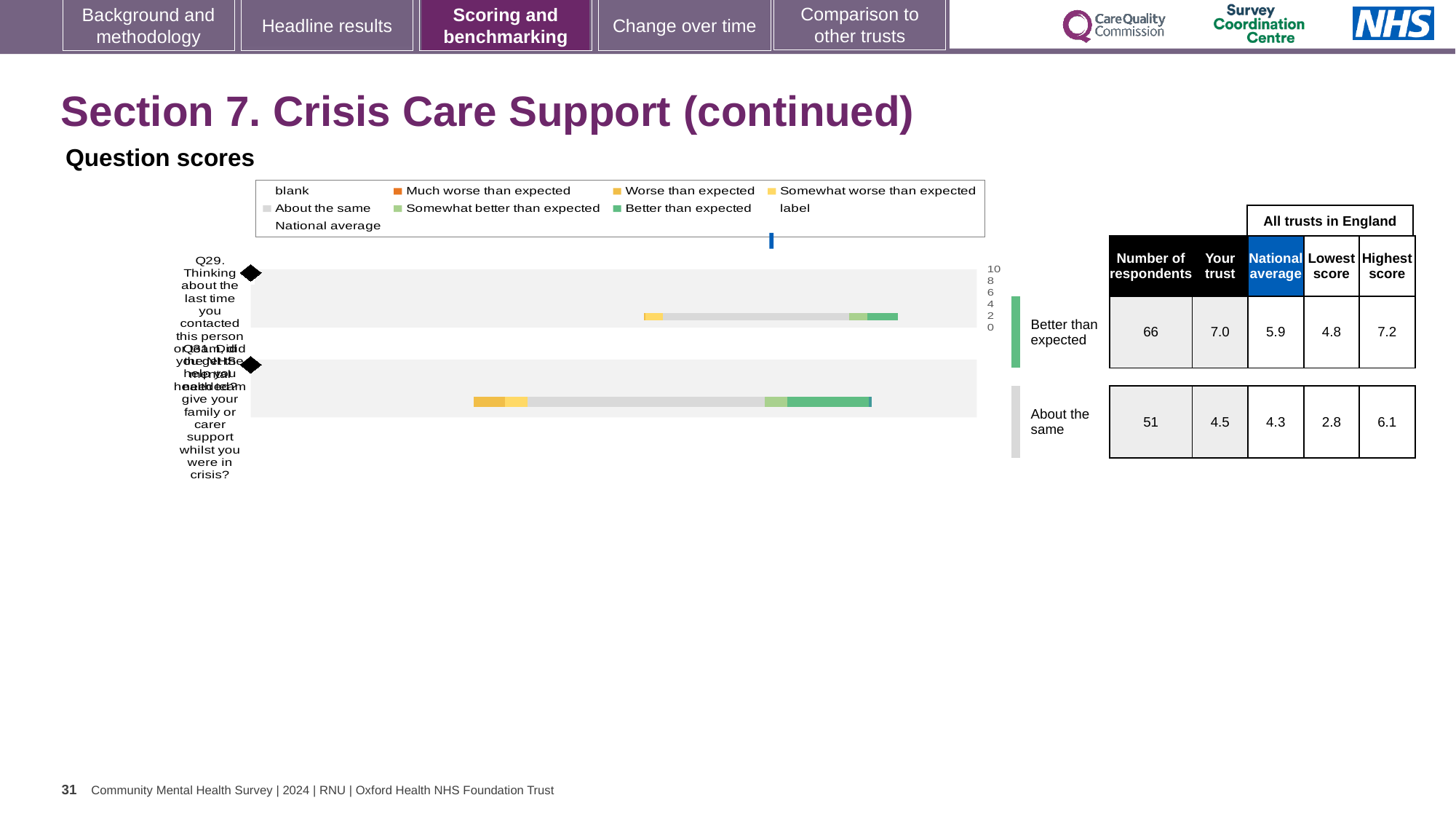
What kind of chart is used to show the question scores on this slide? Bar chart What is the difference between the 'Your trust' score and the national average for Q29? 1.1 In the table next to the chart, what is the highest score among all trusts in England for Q31? 6.1 Which two questions are plotted in the question scores chart? Q29 and Q31 What is the difference in the number of respondents between Q29 and Q31? 15 How many questions (bars) are plotted in the question scores chart? 2 In the question scores chart, what colour represents 'Better than expected' in the legend? Green In the table next to the chart, what is the lowest score among all trusts in England for Q29? 4.8 In the table next to the chart, what is the 'Your trust' score for Q29 (Better than expected)? 7.0 In the table next to the chart, what is the national average for Q31 (About the same)? 4.3 In the table next to the chart, how many respondents answered Q29? 66 For Q29, which is larger: the 'Your trust' score or the national average? Your trust